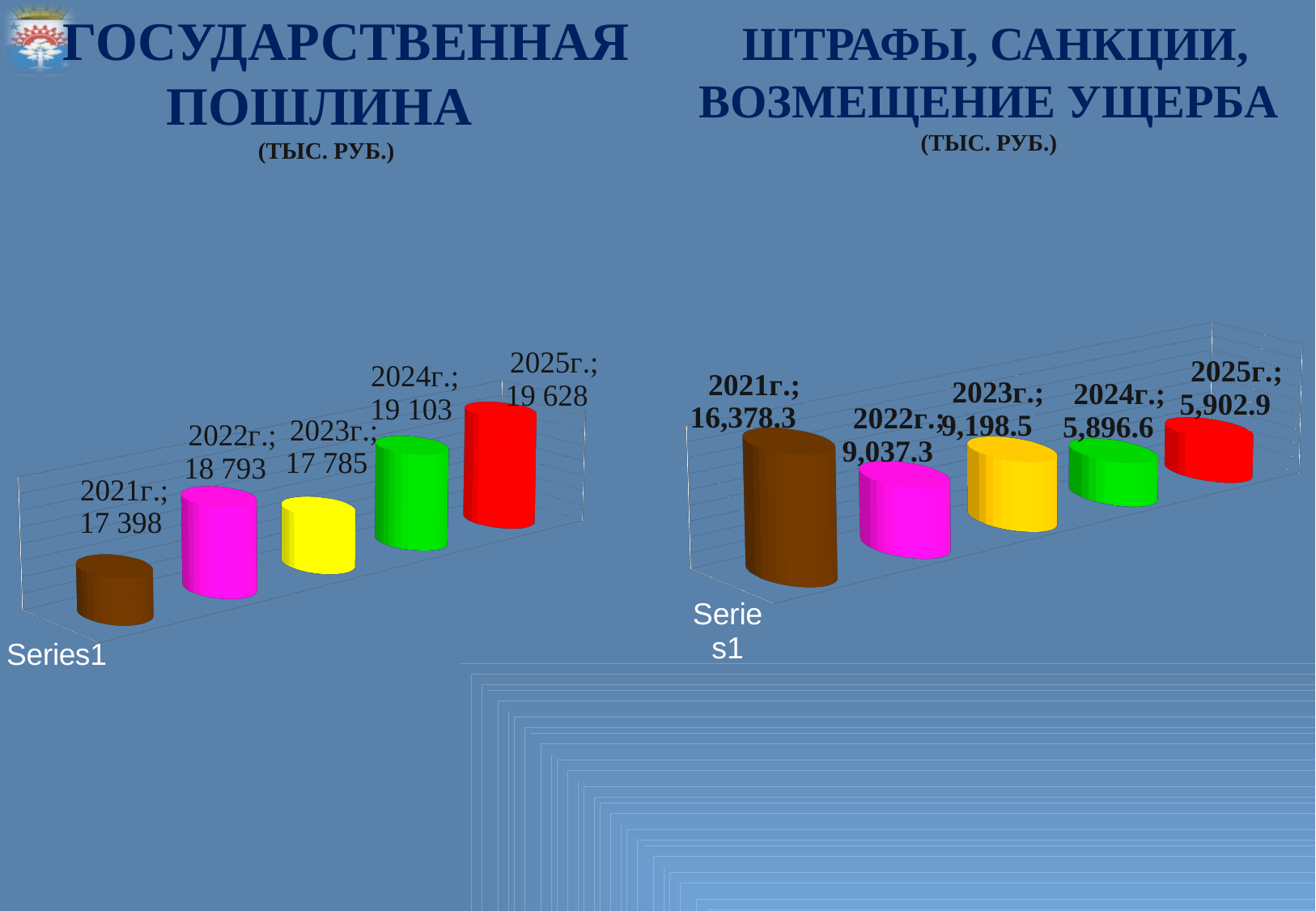
In the ШТРАФЫ, САНКЦИИ, ВОЗМЕЩЕНИЕ УЩЕРБА chart, what is the difference between the 2021г. and 2024г. values? 10,481.7 In the ШТРАФЫ, САНКЦИИ, ВОЗМЕЩЕНИЕ УЩЕРБА chart, what is the value for 2021г.? 16,378.3 What type of chart is the ГОСУДАРСТВЕННАЯ ПОШЛИНА chart? Bar chart In the ГОСУДАРСТВЕННАЯ ПОШЛИНА chart, what is the value for 2024г.? 19 103 In the ГОСУДАРСТВЕННАЯ ПОШЛИНА chart, which is larger, the value for 2022г. or 2023г.? 2022г. In the ГОСУДАРСТВЕННАЯ ПОШЛИНА chart, which year has the lowest value? 2021г. In the ШТРАФЫ, САНКЦИИ, ВОЗМЕЩЕНИЕ УЩЕРБА chart, which year has the highest value? 2021г. In the ШТРАФЫ, САНКЦИИ, ВОЗМЕЩЕНИЕ УЩЕРБА chart, what is the value for 2023г.? 9,198.5 How many years are shown in the ШТРАФЫ, САНКЦИИ, ВОЗМЕЩЕНИЕ УЩЕРБА chart? 5 In the ГОСУДАРСТВЕННАЯ ПОШЛИНА chart, what is the value for 2021г.? 17 398 In the ГОСУДАРСТВЕННАЯ ПОШЛИНА chart, which year has the highest value? 2025г. In the ГОСУДАРСТВЕННАЯ ПОШЛИНА chart, what is the difference between the 2025г. and 2021г. values? 2 230